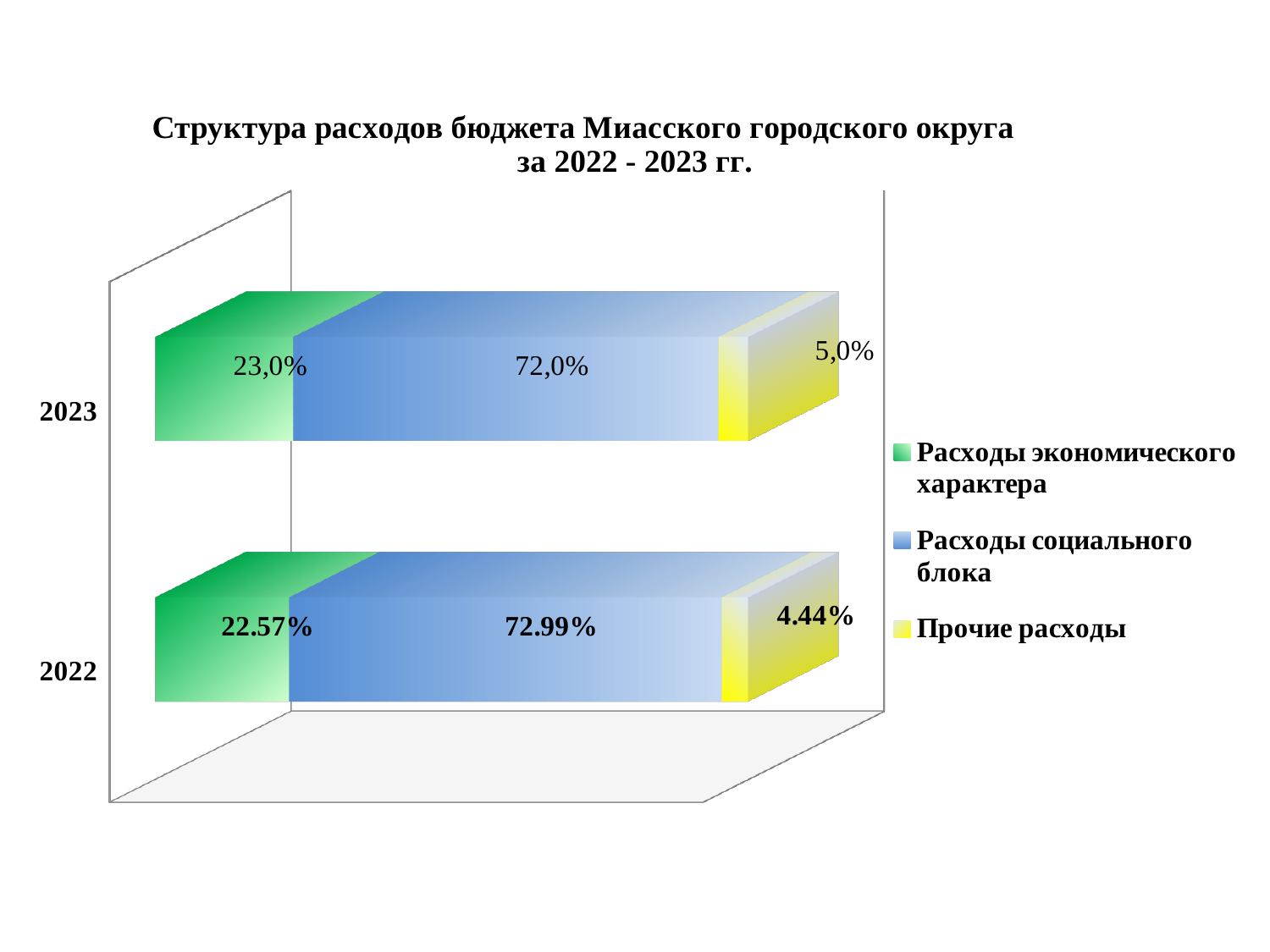
What is the difference between Расходы социального блока and Расходы экономического характера in 2023? 49,0% What is the value for Прочие расходы in 2023? 5,0% What is the difference between Расходы социального блока and Расходы экономического характера in 2022? 50.42% What kind of chart is shown on the slide? stacked bar chart What is the value for Расходы социального блока in 2023? 72,0% What is the value for Прочие расходы in 2022? 4.44% Which series has the largest share in 2022? Расходы социального блока Which is larger: Расходы экономического характера in 2023 or Прочие расходы in 2023? Расходы экономического характера in 2023 What is the value for Расходы экономического характера in 2022? 22.57% How many years (categories) are shown on the chart? 2 Which series has the smallest share in 2023? Прочие расходы How many series does the legend list? 3